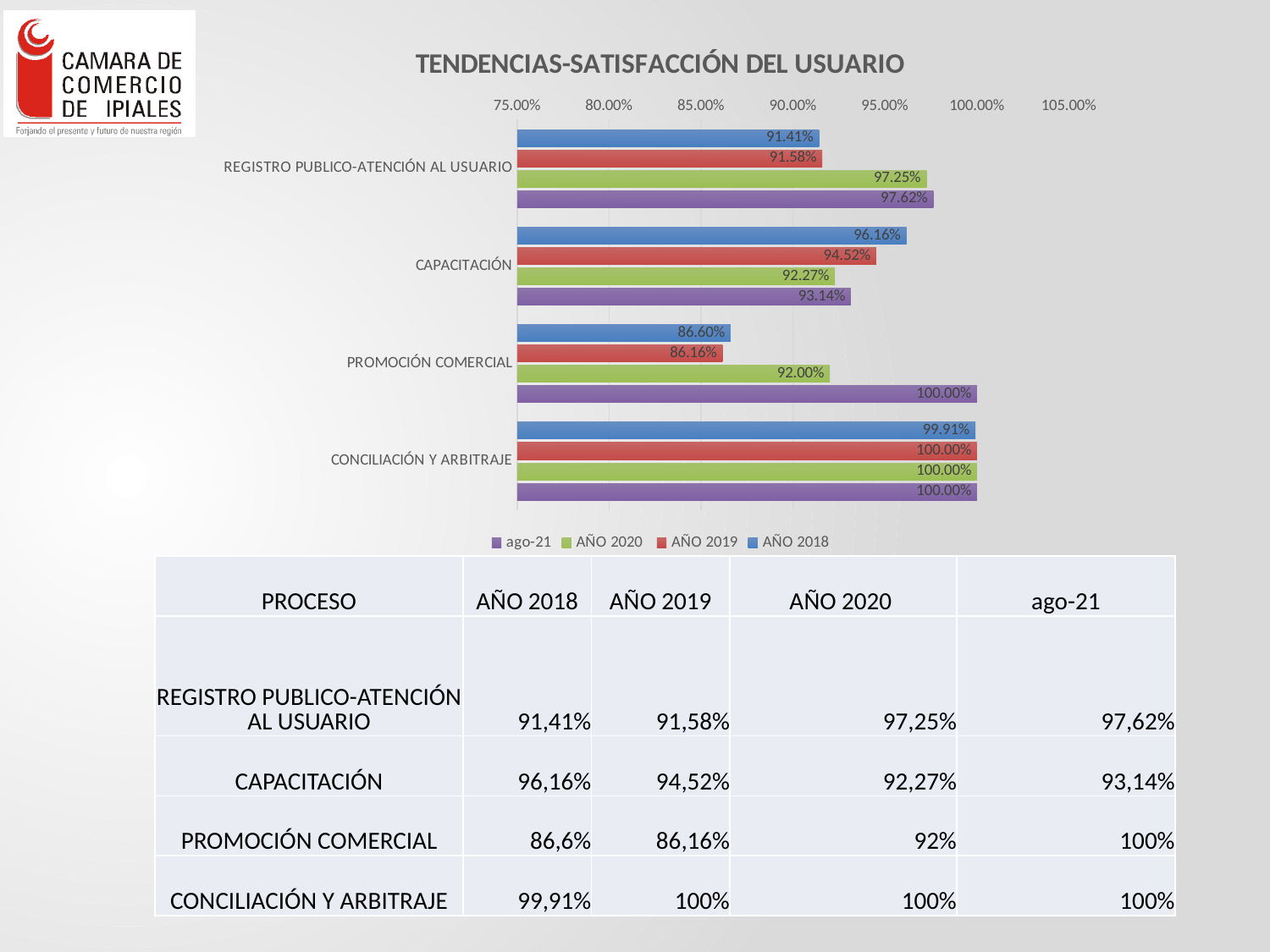
Which category has the lowest AÑO 2019 value in the chart? PROMOCIÓN COMERCIAL What is the ago-21 value for PROMOCIÓN COMERCIAL in the chart? 100.00% Is the AÑO 2019 value for PROMOCIÓN COMERCIAL greater or less than 90.00%? less What is the AÑO 2019 value for REGISTRO PUBLICO-ATENCIÓN AL USUARIO in the chart? 91.58% What is the AÑO 2020 value for CAPACITACIÓN in the chart? 92.27% How many series does the chart legend list? 4 Which category has the highest AÑO 2018 value in the chart? CONCILIACIÓN Y ARBITRAJE What is the AÑO 2018 value for CONCILIACIÓN Y ARBITRAJE in the chart? 99.91% How many categories (processes) are shown in the chart? 4 What is the difference between the ago-21 and AÑO 2018 values for PROMOCIÓN COMERCIAL? 13.40% What type of chart is shown on the slide? Bar chart For CAPACITACIÓN, which is larger: the AÑO 2018 value or the AÑO 2020 value? AÑO 2018